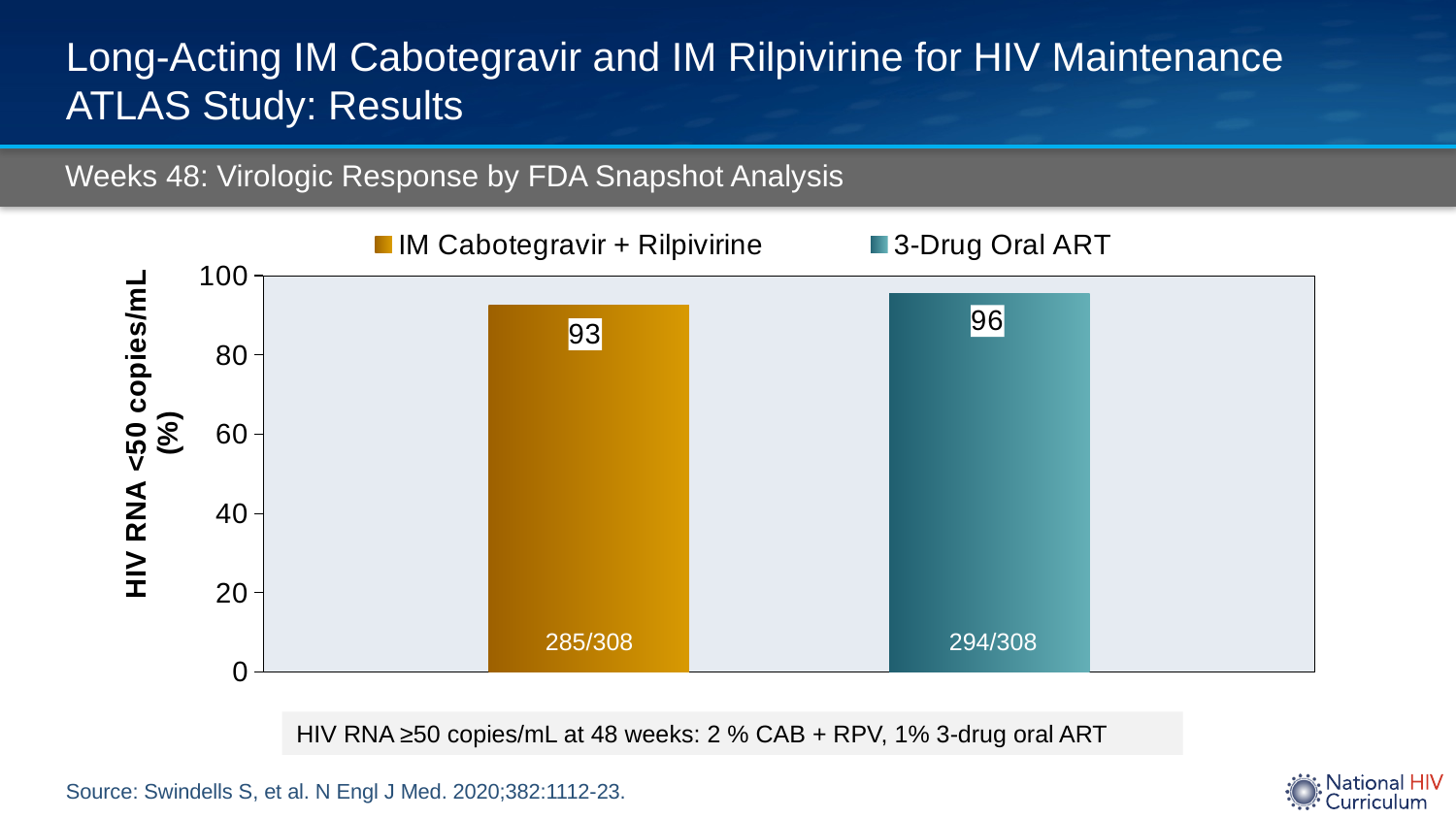
What fraction is printed inside the 3-Drug Oral ART bar? 294/308 How many series does the legend list? 2 What is the difference between the 3-Drug Oral ART value and the IM Cabotegravir + Rilpivirine value? 3 What kind of chart is shown? bar chart Which series has the higher value? 3-Drug Oral ART Which series has the lower value? IM Cabotegravir + Rilpivirine What is the value for 3-Drug Oral ART? 96 What fraction is printed inside the IM Cabotegravir + Rilpivirine bar? 285/308 What is the y-axis label of the chart? HIV RNA <50 copies/mL (%) What is the value for IM Cabotegravir + Rilpivirine? 93 Is the value for IM Cabotegravir + Rilpivirine greater or less than 80? greater How many bars are plotted on the chart? 2